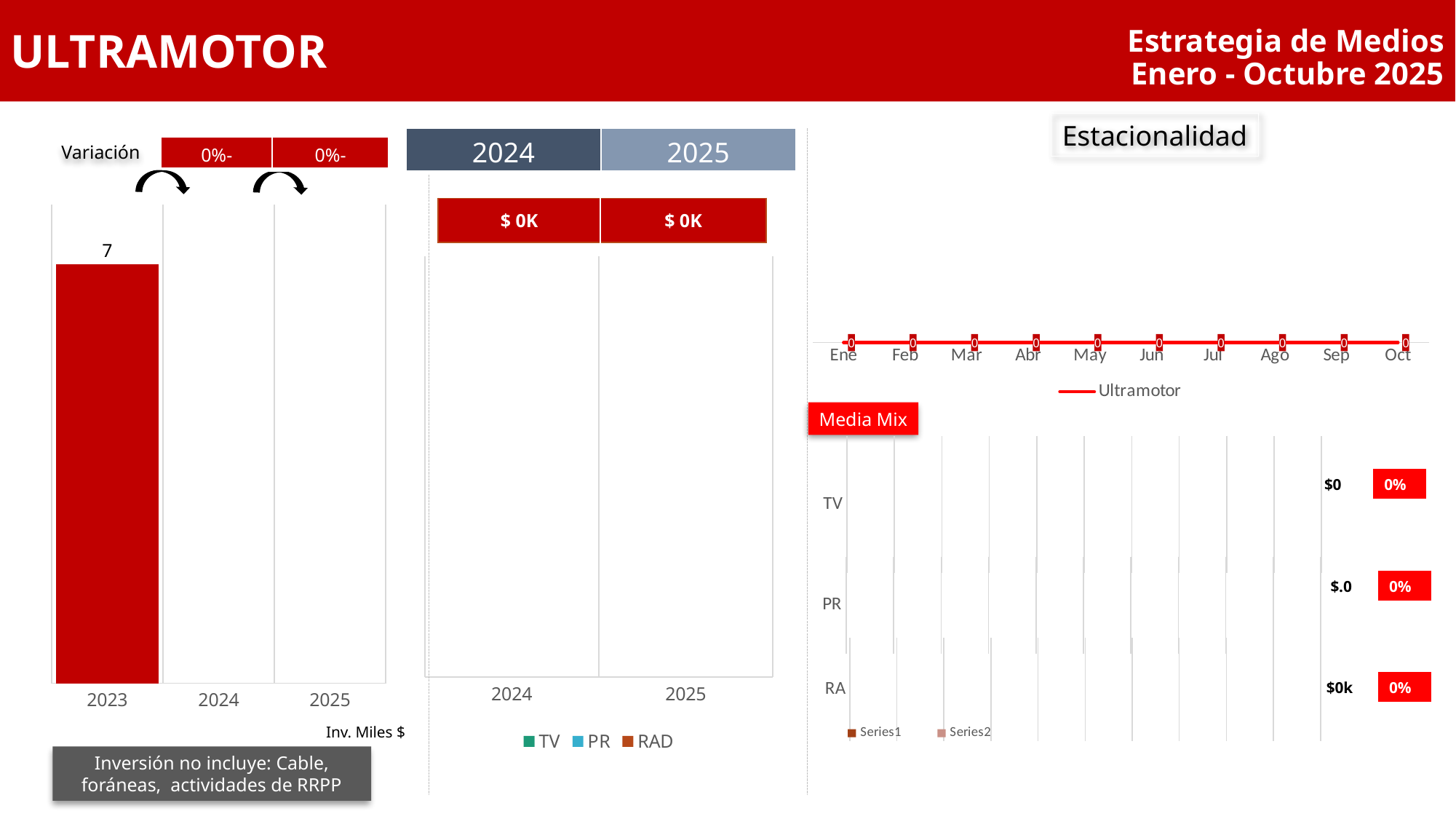
On the middle chart (2024 vs 2025), what are the legend entries? TV, PR, RAD On the left bar chart (2023–2025), which year has the highest value? 2023 On the left bar chart (2023–2025), how many year categories are shown on the x axis? 3 What kind of chart is the left chart showing 2023, 2024 and 2025? bar chart On the Estacionalidad line chart, how many months are shown on the x axis? 10 On the Estacionalidad line chart, do the values rise, fall or stay flat from Ene to Oct? stay flat On the middle chart (2024 vs 2025), what total value is shown in the red box above 2025? $ 0K On the Media Mix chart, how many series does the legend list? 2 On the left bar chart, what unit label is shown below the x axis? Inv. Miles $ On the middle chart (2024 vs 2025), how many series does the legend list? 3 On the left bar chart (2023–2025), what is the value for 2023? 7 On the Estacionalidad line chart, what is the value for Mar? 0